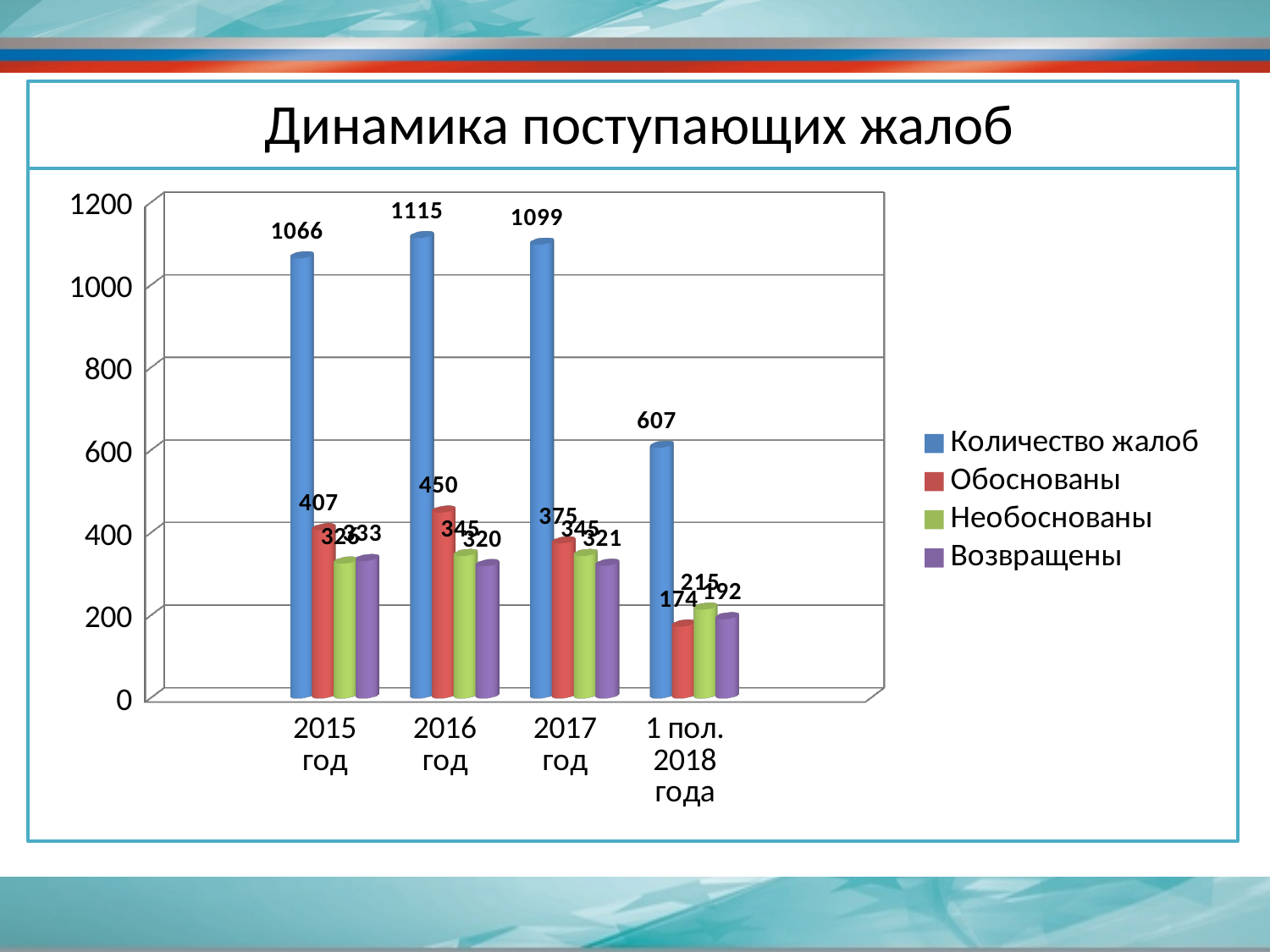
What is the value of Количество жалоб for 2016 год? 1115 What is the value of Возвращены for 1 пол. 2018 года? 192 What is the value of Обоснованы for 2015 год? 407 What kind of chart is shown on the slide? Bar chart What is the title of the chart? Динамика поступающих жалоб Which category has the lowest value for Обоснованы? 1 пол. 2018 года Which category has the highest value for Количество жалоб? 2016 год How many series does the legend list? 4 Which is larger: Обоснованы for 2016 год or Обоснованы for 2017 год? Обоснованы for 2016 год What is the difference between Количество жалоб for 2016 год and 2017 год? 16 What is the value of Необоснованы for 2017 год? 345 How many categories are shown on the x axis? 4